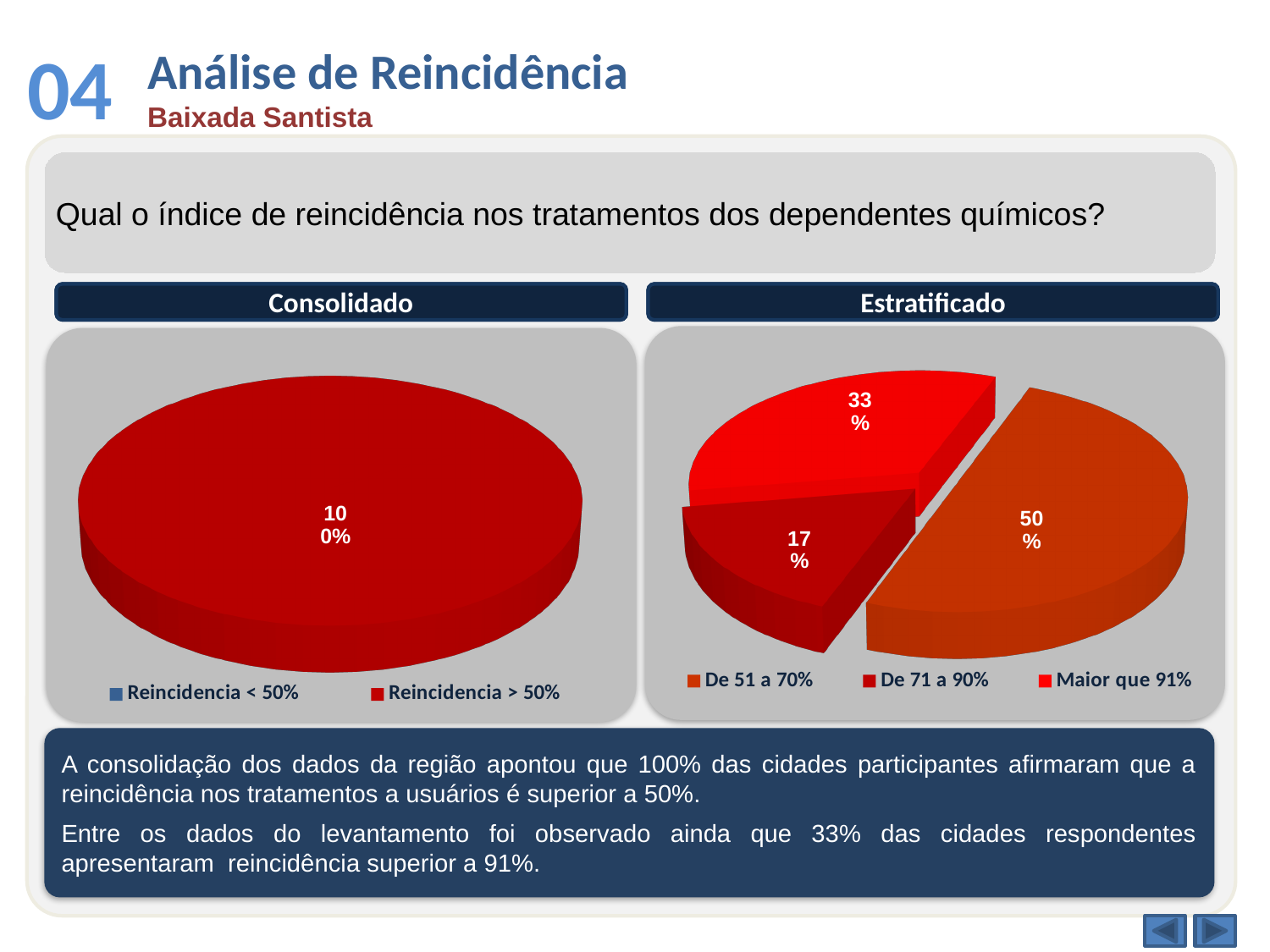
In the Estratificado chart, what share is shown for De 51 a 70%? 50% In the Estratificado chart, which is larger: the share for Maior que 91% or the share for De 71 a 90%? Maior que 91% What is the title shown above the chart on the right? Estratificado How many slices does the Estratificado chart have? 3 How many entries does the legend of the Consolidado chart list? 2 In the Estratificado chart, what share is shown for De 71 a 90%? 17% In the Consolidado chart, what share is shown for Reincidencia > 50%? 100% In the Estratificado chart, which category has the smallest slice? De 71 a 90% In the Estratificado chart, what share is shown for Maior que 91%? 33% In the Estratificado chart, which category has the largest slice? De 51 a 70% What kind of chart is the Consolidado chart? pie chart In the Estratificado chart, what is the difference between the shares for De 51 a 70% and Maior que 91%? 17%